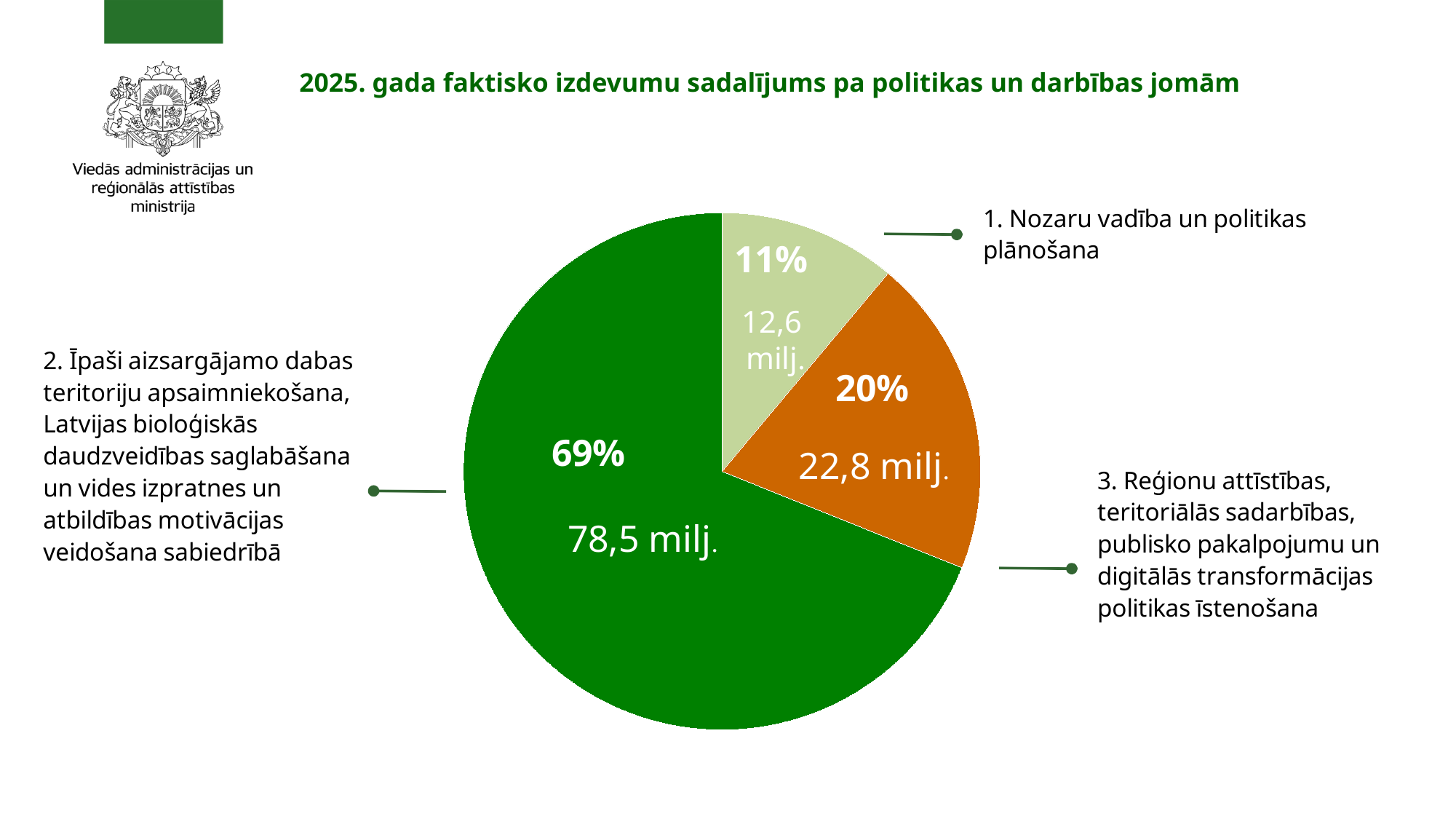
Which category has the largest slice of the pie? 2. Īpaši aizsargājamo dabas teritoriju apsaimniekošana, Latvijas bioloģiskās daudzveidības saglabāšana un vides izpratnes un atbildības motivācijas veidošana sabiedrībā What is the difference in milj. between the slice for category 2 (78,5 milj.) and the slice for category 3 (22,8 milj.)? 55,7 milj. What is the value shown for "3. Reģionu attīstības, teritoriālās sadarbības, publisko pakalpojumu un digitālās transformācijas politikas īstenošana"? 22,8 milj. What is the title of the chart? 2025. gada faktisko izdevumu sadalījums pa politikas un darbības jomām What is the value shown for "1. Nozaru vadība un politikas plānošana"? 12,6 milj. Which is larger: the slice for "3. Reģionu attīstības..." or the slice for "1. Nozaru vadība un politikas plānošana"? 3. Reģionu attīstības, teritoriālās sadarbības, publisko pakalpojumu un digitālās transformācijas politikas īstenošana What share of the pie does "3. Reģionu attīstības, teritoriālās sadarbības, publisko pakalpojumu un digitālās transformācijas politikas īstenošana" have? 20% Which category has the smallest slice of the pie? 1. Nozaru vadība un politikas plānošana How many slices does the pie chart have? 3 What kind of chart is shown on the slide? pie chart What share of the pie does "2. Īpaši aizsargājamo dabas teritoriju apsaimniekošana, Latvijas bioloģiskās daudzveidības saglabāšana un vides izpratnes un atbildības motivācijas veidošana sabiedrībā" have? 69% What share of the pie does "1. Nozaru vadība un politikas plānošana" have? 11%